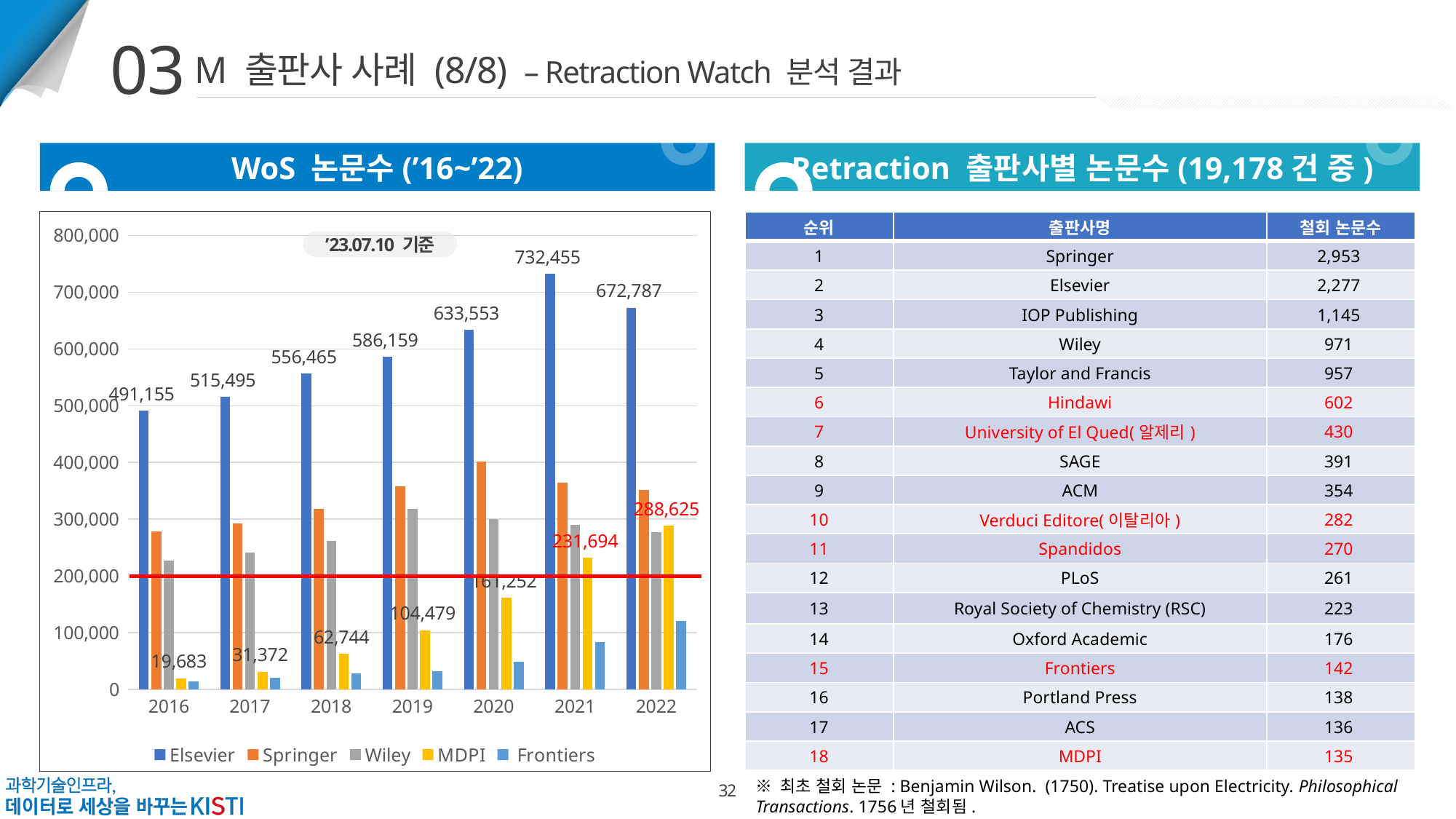
In the WoS 논문수 chart, what is the value for Elsevier in 2018? 556,465 In the WoS 논문수 chart, what is the value for MDPI in 2016? 19,683 In the WoS 논문수 chart, in which year is the MDPI value lowest? 2016 In the WoS 논문수 chart, what is the value for Elsevier in 2021? 732,455 In the WoS 논문수 chart, in which year is the Elsevier value highest? 2021 In the WoS 논문수 chart, do the MDPI values rise or fall from 2016 to 2022? rise How many series does the legend of the WoS 논문수 chart list? 5 In the WoS 논문수 chart, is the value for Springer in 2020 greater or less than 300,000? greater In the WoS 논문수 chart, what is the difference between the Elsevier values for 2021 and 2022? 59,668 How many years are shown on the x axis of the WoS 논문수 chart? 7 What kind of chart is shown under the title 'WoS 논문수 ('16~'22)'? bar chart In the WoS 논문수 chart, which is larger in 2021: Springer or Wiley? Springer